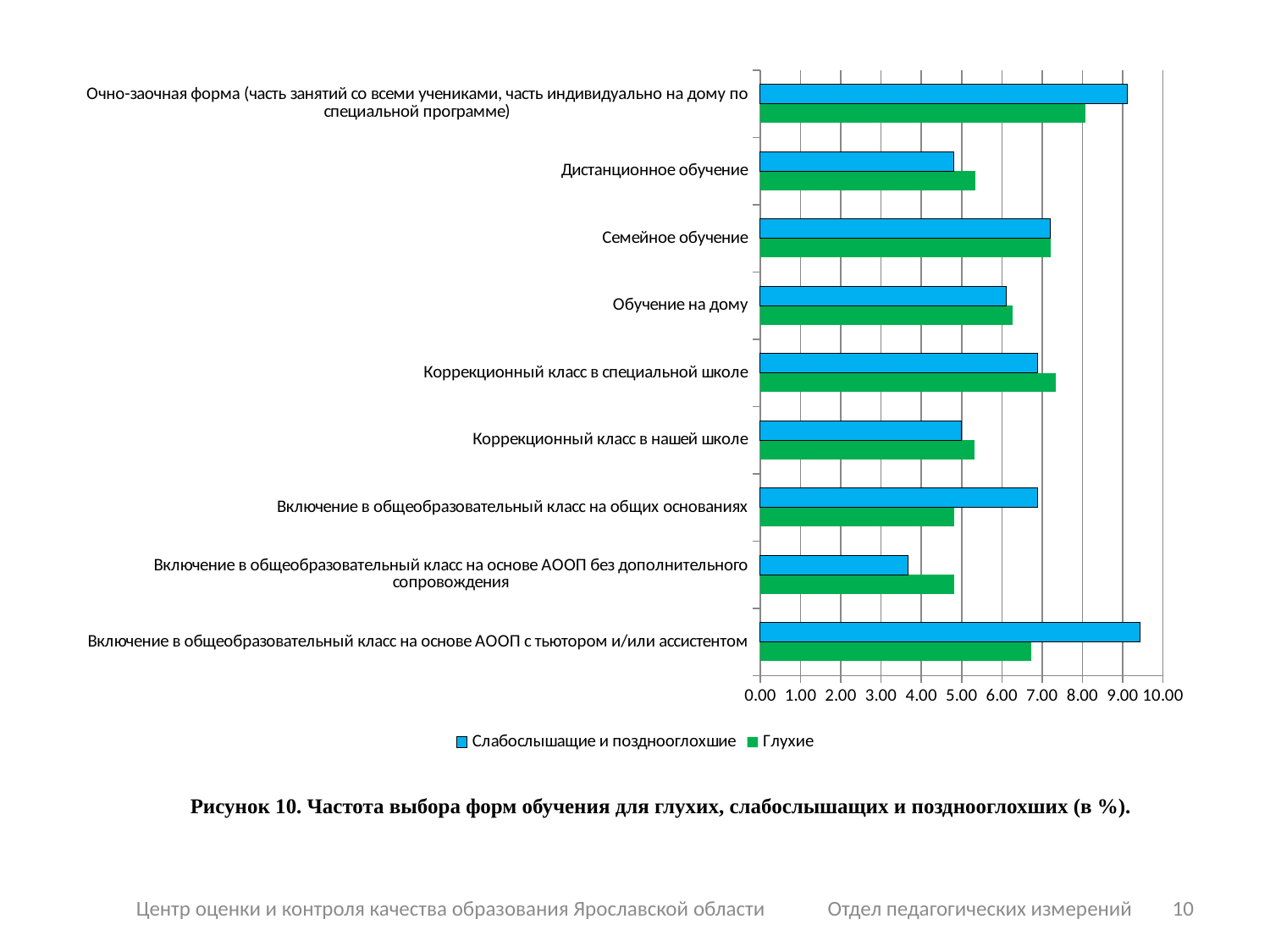
Is the value for 'Слабослышащие и позднооглохшие' in 'Дистанционное обучение' greater or less than 6.00? less For 'Включение в общеобразовательный класс на общих основаниях', which series has the larger value? Слабослышащие и позднооглохшие How many series does the legend list? 2 Which category has the highest value for the series 'Глухие'? Очно-заочная форма (часть занятий со всеми учениками, часть индивидуально на дому по специальной программе) For 'Включение в общеобразовательный класс на основе АООП с тьютором и/или ассистентом', which series has the larger value? Слабослышащие и позднооглохшие Which category has the lowest value for the series 'Слабослышащие и позднооглохшие'? Включение в общеобразовательный класс на основе АООП без дополнительного сопровождения What kind of chart is shown on the slide? bar chart Is the value for 'Глухие' in 'Обучение на дому' greater or less than 7.00? less Which colour represents the series 'Глухие' in the chart? green For 'Включение в общеобразовательный класс на основе АООП без дополнительного сопровождения', which series has the larger value? Глухие Is the value for 'Слабослышащие и позднооглохшие' in 'Очно-заочная форма' greater or less than 8.00? greater How many categories (forms of education) are shown on the chart? 9